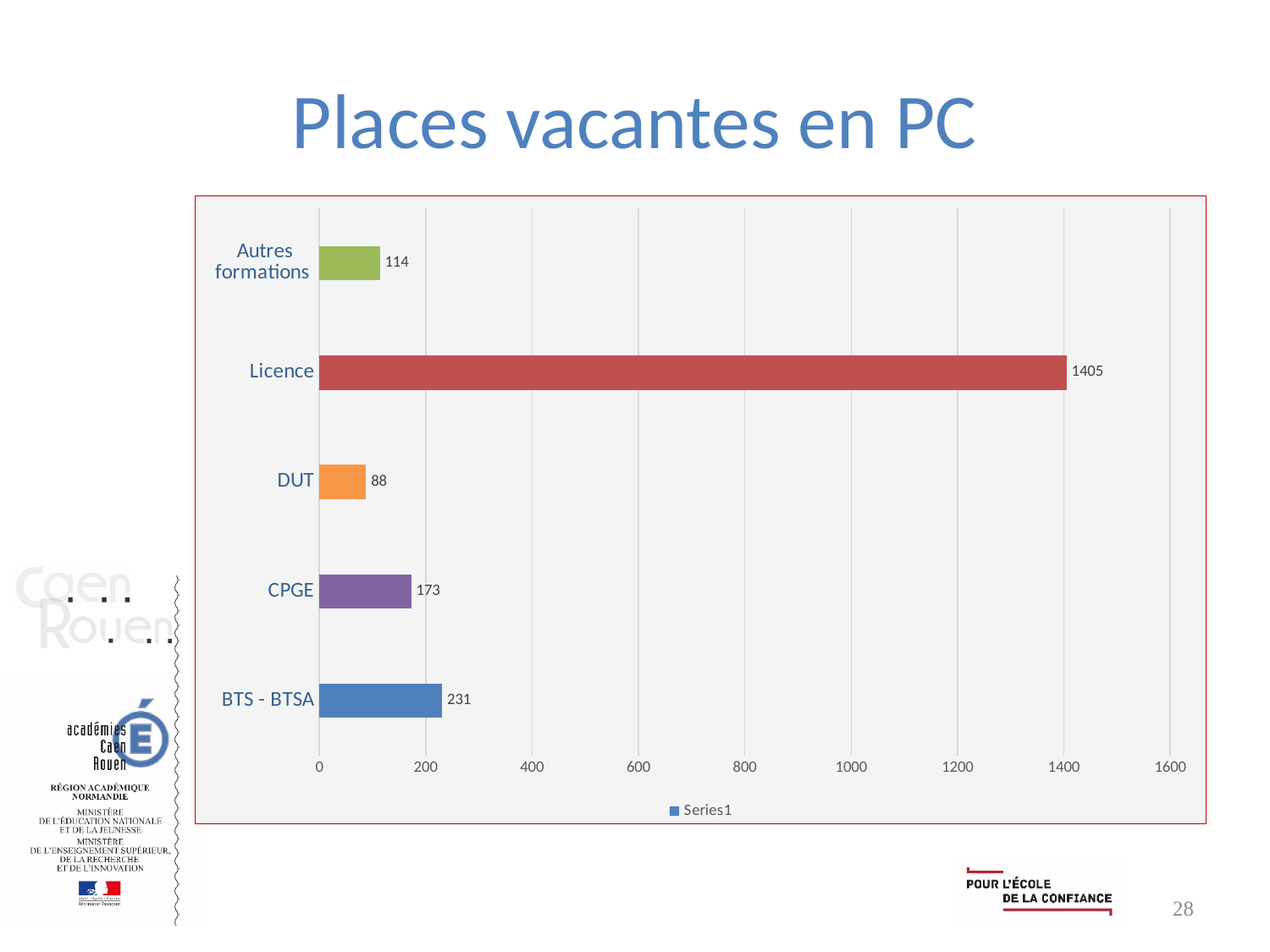
What is the value for Autres formations? 114 Which category has the lowest value? DUT What is the value for DUT? 88 What is the value for BTS - BTSA? 231 How many categories are shown in the chart? 5 Which category has the highest value? Licence What is the title of the slide? Places vacantes en PC What is the difference between the values for BTS - BTSA and CPGE? 58 Which is larger, the value for CPGE or the value for Autres formations? CPGE Is the value for Licence greater or less than 1200? greater What kind of chart is shown on the slide? bar chart What is the value for Licence? 1405